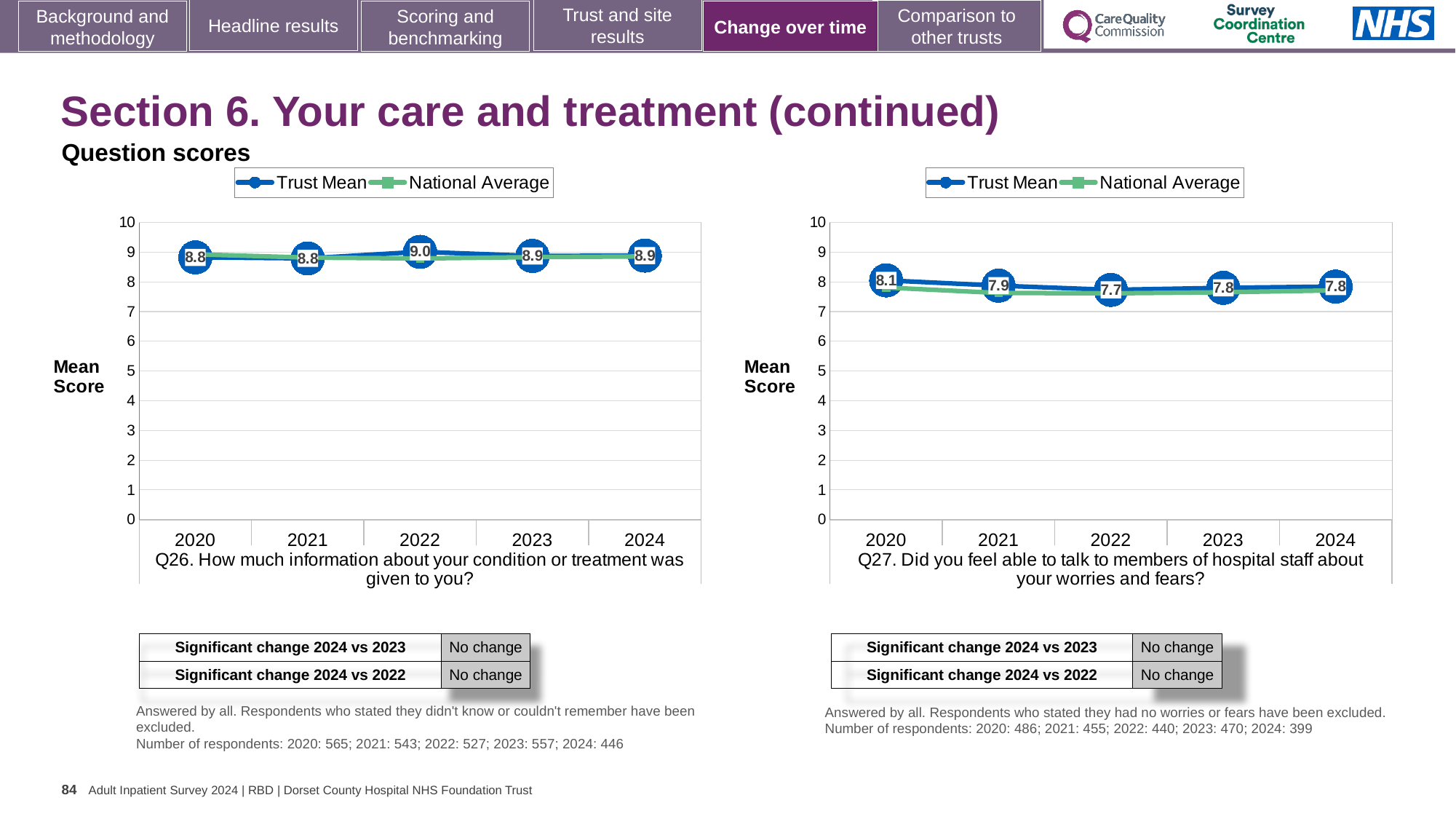
In the Q27 chart (right), what is the Trust Mean score for 2024? 7.8 In the Q26 chart (left), what is the Trust Mean score for 2022? 9.0 How many years are plotted on the x axis of the Q26 chart (left)? 5 What kind of chart is the Q26 chart (left)? Line chart In the Q26 chart (left), which year has the highest Trust Mean score? 2022 In the Q27 chart (right), what is the difference between the Trust Mean scores for 2020 and 2022? 0.4 In the Q27 chart (right), which year has the lowest Trust Mean score? 2022 In the Q27 chart (right), is the National Average for 2020 greater or less than 7? greater In the Q27 chart (right), does the Trust Mean score rise or fall from 2020 to 2022? Fall In the Q26 chart (left), which is larger: the Trust Mean score for 2021 or for 2022? 2022 How many series does the legend of the Q27 chart (right) list? 2 In the Q27 chart (right), what is the Trust Mean score for 2020? 8.1